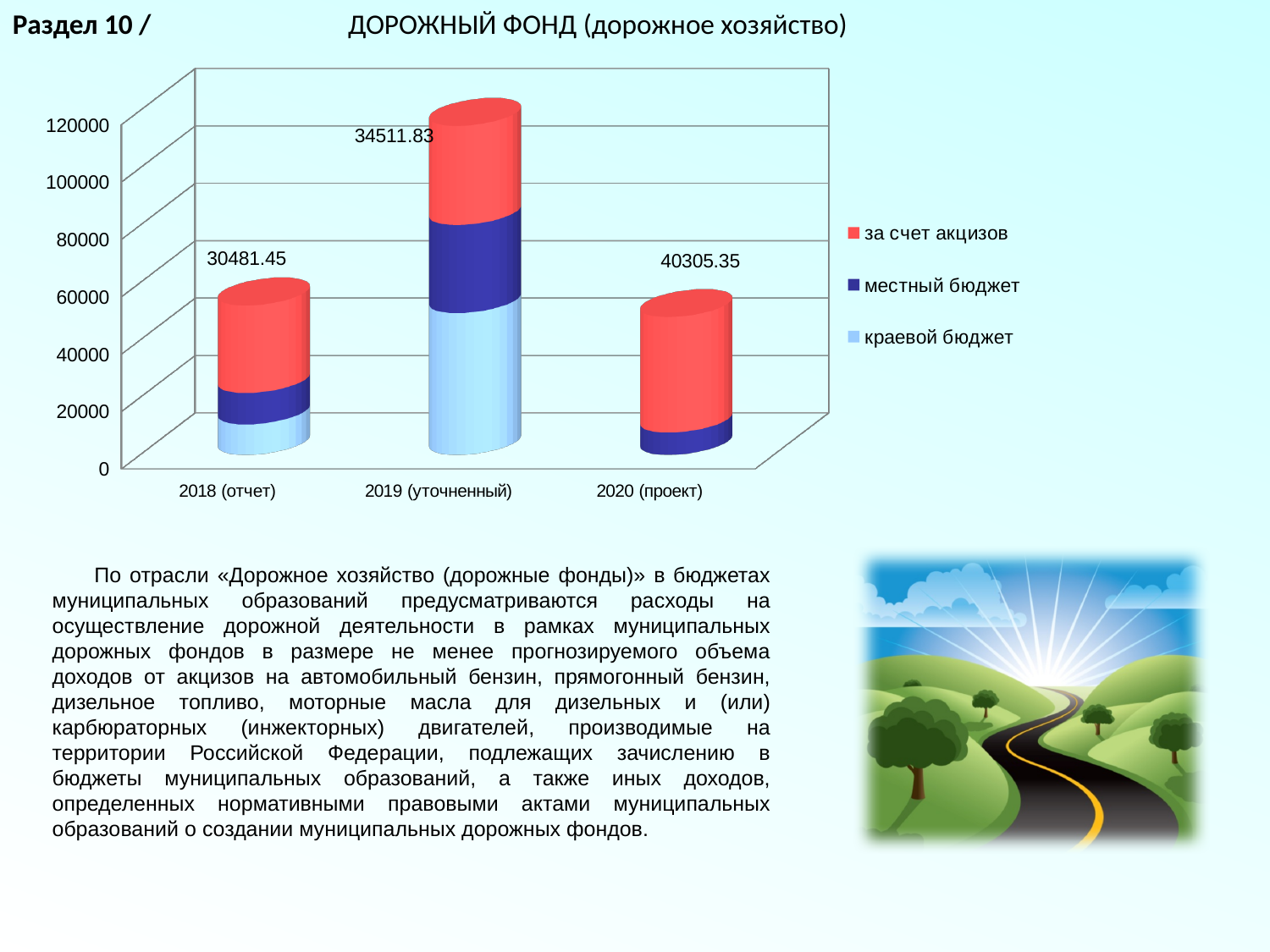
What is the value labelled for 'за счет акцизов' in 2018 (отчет)? 30481.45 In which year is the labelled 'за счет акцизов' value the lowest? 2018 (отчет) What is the difference between the 'за счет акцизов' values for 2020 (проект) and 2018 (отчет)? 9823.90 Which is larger, the 'за счет акцизов' value for 2019 (уточненный) or for 2018 (отчет)? 2019 (уточненный) How many series does the legend list? 3 Is the total height of the 2018 (отчет) stacked bar greater or less than 80000? less What is the value labelled for 'за счет акцизов' in 2020 (проект)? 40305.35 What kind of chart is shown on the slide? Stacked bar chart How many categories (years) are shown on the x axis? 3 What is the value labelled for 'за счет акцизов' in 2019 (уточненный)? 34511.83 Is the total height of the 2019 (уточненный) stacked bar greater or less than 100000? greater In which year is the labelled 'за счет акцизов' value the highest? 2020 (проект)